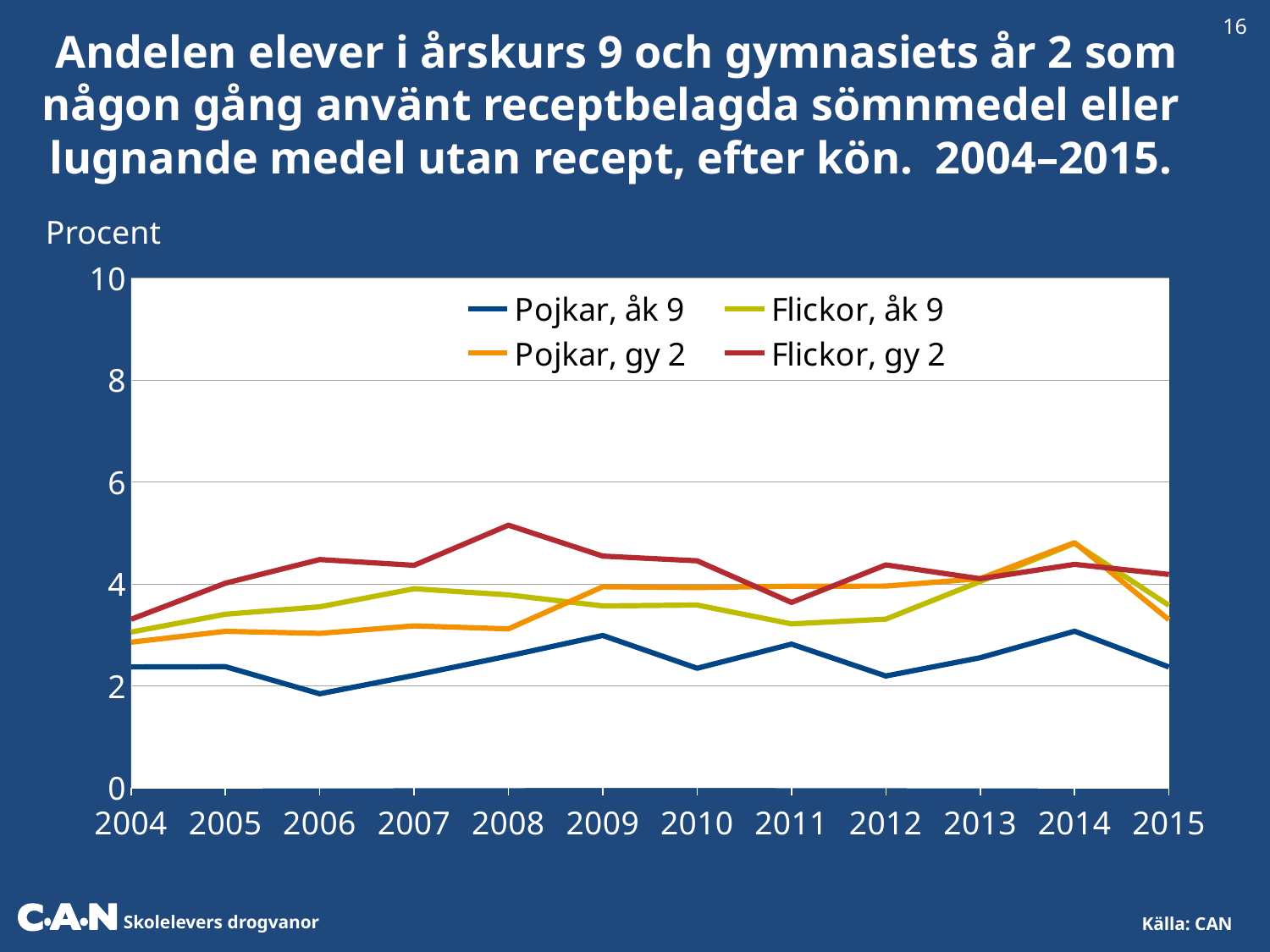
How many series does the legend list? 4 Which series has the lowest value in 2004? Pojkar, åk 9 Is the value for Pojkar, åk 9 in 2006 greater or less than 2? less What kind of chart is shown on the slide? line chart What label is shown above the y axis of the chart? Procent Which series has the highest value in 2008? Flickor, gy 2 In 2008, which is larger: the value for Flickor, gy 2 or the value for Pojkar, åk 9? Flickor, gy 2 Is the value for Pojkar, gy 2 in 2014 greater or less than 4? greater Is the value for Flickor, gy 2 in 2008 greater or less than 4? greater How many years are shown along the x axis? 12 In which year does the Flickor, gy 2 line reach its highest value? 2008 Does the Flickor, gy 2 line rise or fall from 2004 to 2008? rise